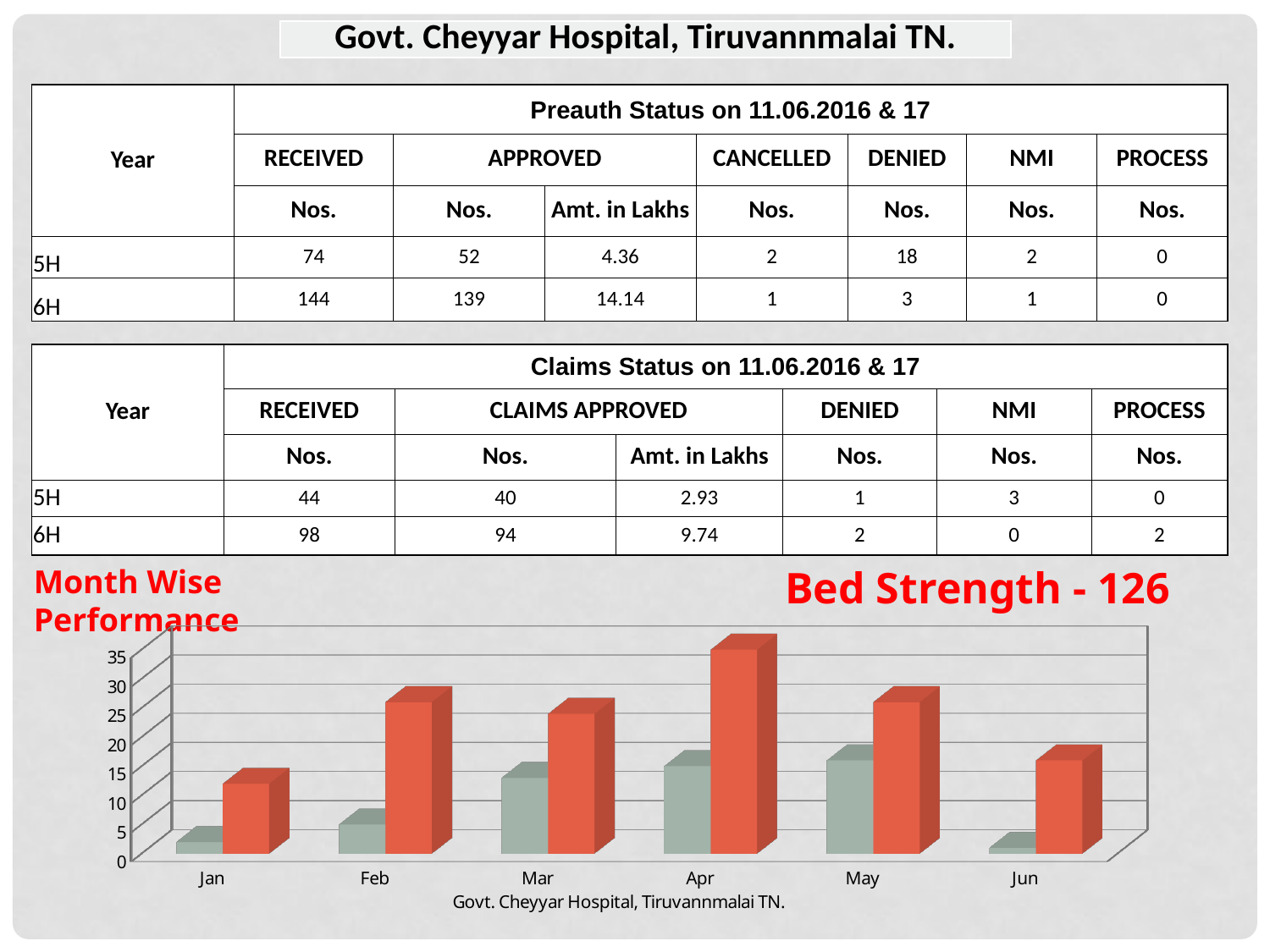
How many months are shown on the x axis of the bar chart? 6 Which month has the shortest red bar in the bar chart? Jan Which month has the tallest red bar in the bar chart? Apr What text appears below the x axis of the bar chart? Govt. Cheyyar Hospital, Tiruvannmalai TN. Which is larger in the bar chart, the red bar for Apr or the red bar for Jan? Apr What kind of chart is shown at the bottom of the slide? bar chart Is the red bar for Feb greater or less than 20? greater Is the grey bar for Jan greater or less than 5? less Is the red bar for Jan greater or less than 20? less Which is larger in the bar chart, the grey bar for May or the grey bar for Jun? May